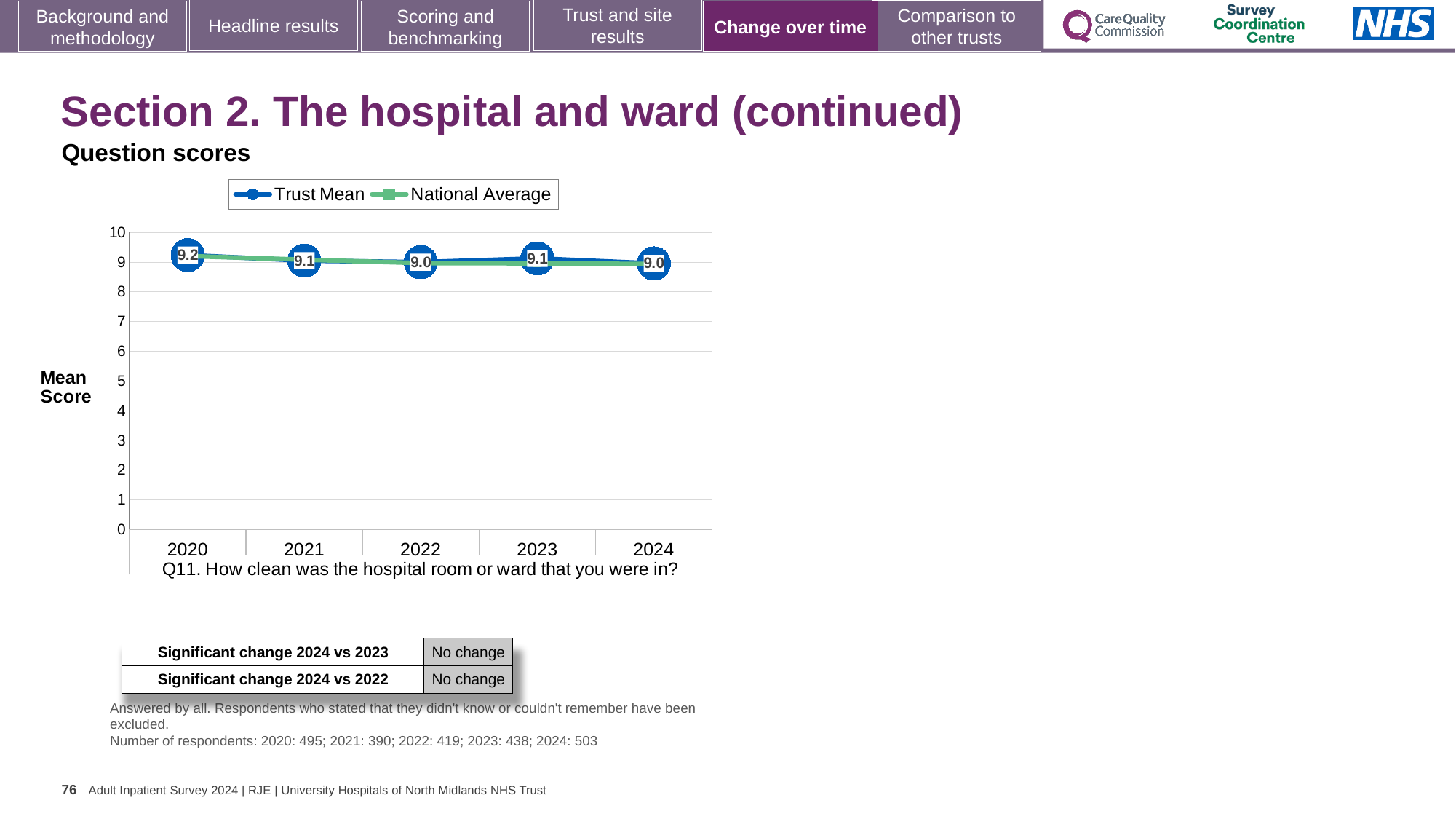
In which year is the Trust Mean score highest? 2020 Does the Trust Mean score rise or fall overall from 2020 to 2024? Fall What is the label of the y axis of the chart? Mean Score How many series does the chart legend list? 2 What is the difference between the Trust Mean score in 2020 and in 2024? 0.2 What is the Trust Mean score for 2020 in the Q11 chart? 9.2 Is the National Average value for 2024 greater or less than 8? greater What is the Trust Mean score for 2021? 9.1 What kind of chart is shown on the slide? Line chart Which year has the larger Trust Mean score, 2020 or 2021? 2020 How many years are plotted on the x axis of the chart? 5 What is the Trust Mean score for 2024 in the Q11 chart? 9.0